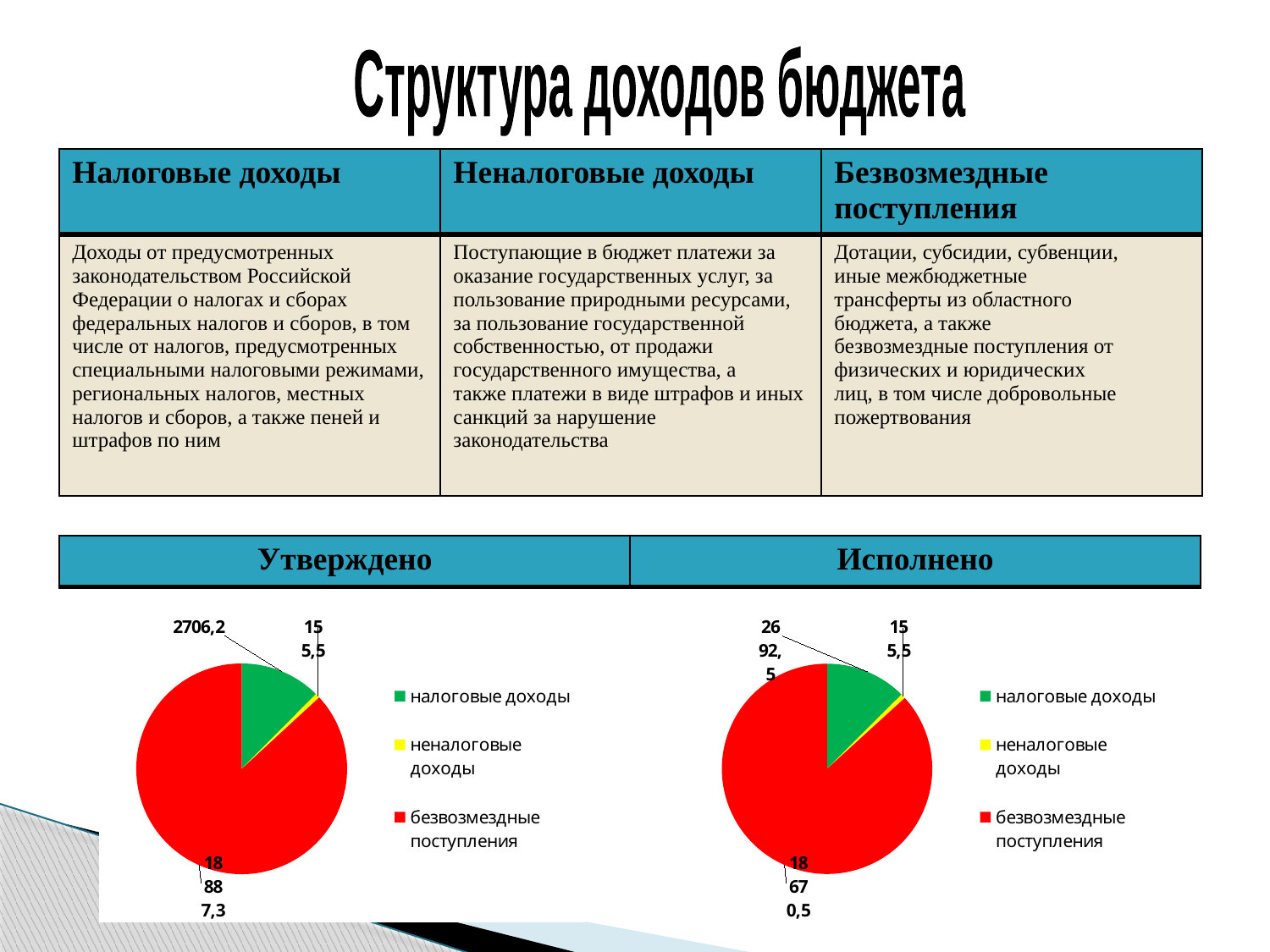
In the "Утверждено" chart, how many series does the legend list? 3 In the "Исполнено" chart, which category has the largest slice? безвозмездные поступления What kind of chart is shown under "Утверждено"? pie chart In the "Исполнено" chart, how many slices does the pie have? 3 In the "Исполнено" chart, what colour is the slice for безвозмездные поступления? red How many charts are on the slide? 2 In the "Исполнено" chart, which is larger: налоговые доходы or неналоговые доходы? налоговые доходы In the "Утверждено" chart, which category has the largest slice? безвозмездные поступления In the "Утверждено" chart, what is the value for налоговые доходы? 2706,2 What is the heading above the left pie chart? Утверждено In the "Исполнено" chart, which category has the smallest slice? неналоговые доходы In the "Утверждено" chart, which is larger: безвозмездные поступления or налоговые доходы? безвозмездные поступления